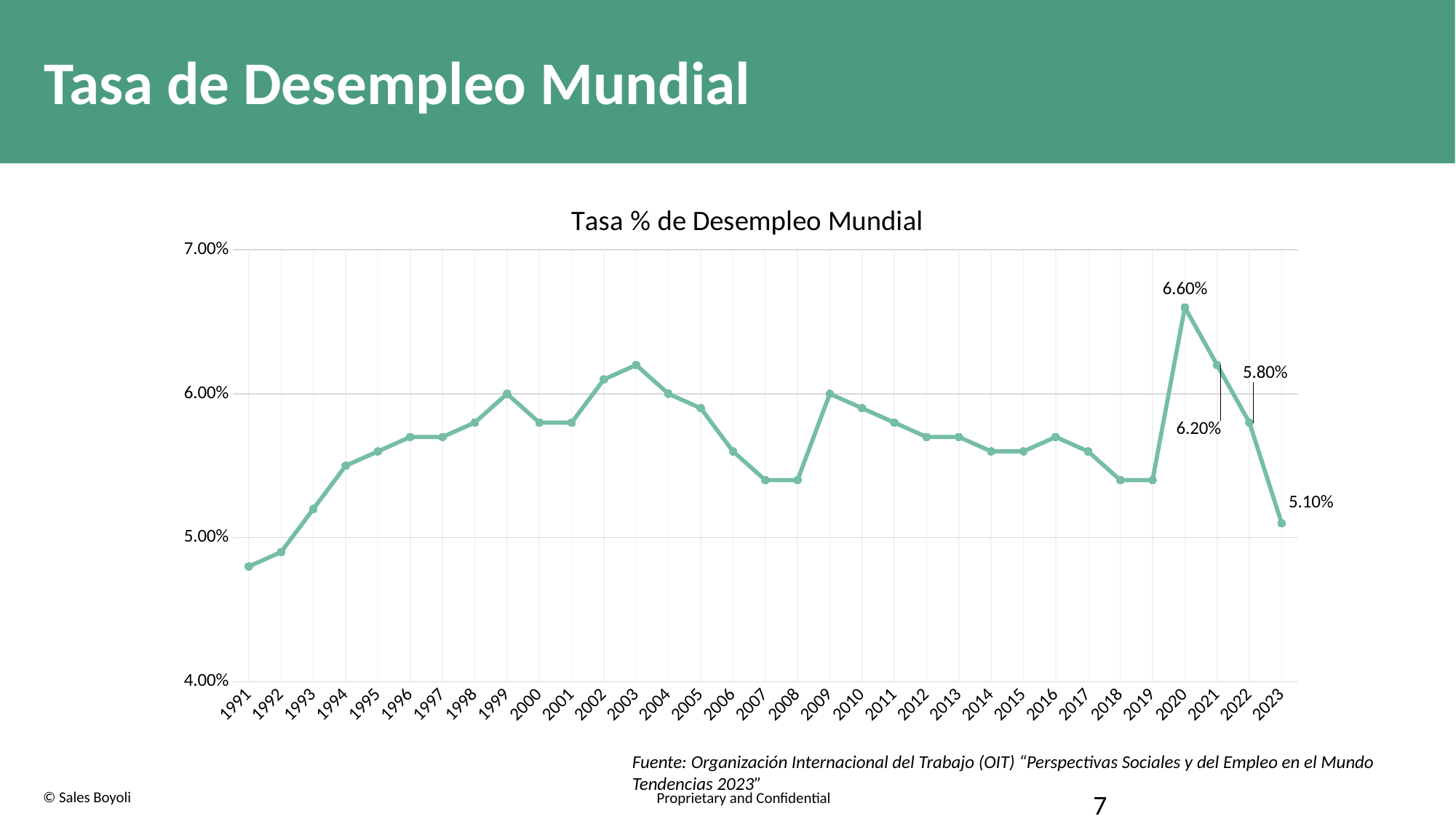
Which year has the highest unemployment rate? 2020 What kind of chart is shown? line chart What is the difference between the values for 2020 and 2023? 1.50% Is the value for 1991 greater or less than 5.00%? less Which is larger, the value for 2021 or the value for 2023? 2021 What is the value for 2020? 6.60% What is the difference between the values for 2021 and 2022? 0.40% Which year has the lowest unemployment rate? 1991 How many years are plotted on the x axis? 33 What is the value for 2022? 5.80% What is the value for 2023? 5.10% Is the value for 2003 greater or less than 6.00%? greater